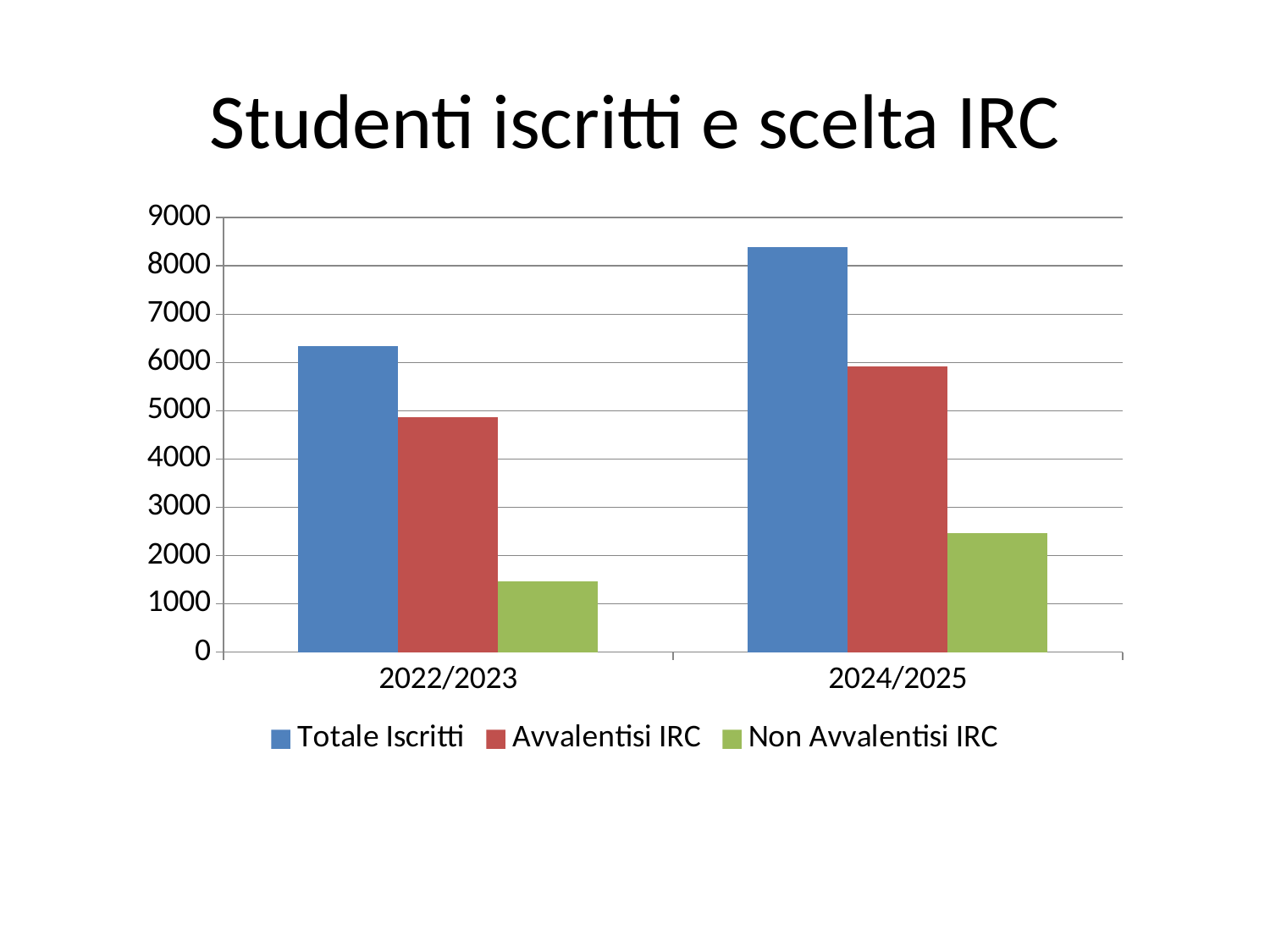
What kind of chart is shown on the slide? bar chart How many series does the legend list? 3 Which series has the highest value in 2024/2025? Totale Iscritti Is Avvalentisi IRC larger in 2022/2023 or in 2024/2025? 2024/2025 How many school-year categories are shown on the x axis? 2 Is the value for Totale Iscritti in 2022/2023 greater or less than 6000? greater What is the title of the chart? Studenti iscritti e scelta IRC Is the value for Totale Iscritti in 2024/2025 greater or less than 8000? greater Which series has the lowest value in 2022/2023? Non Avvalentisi IRC Is the value for Non Avvalentisi IRC in 2024/2025 greater or less than 2000? greater